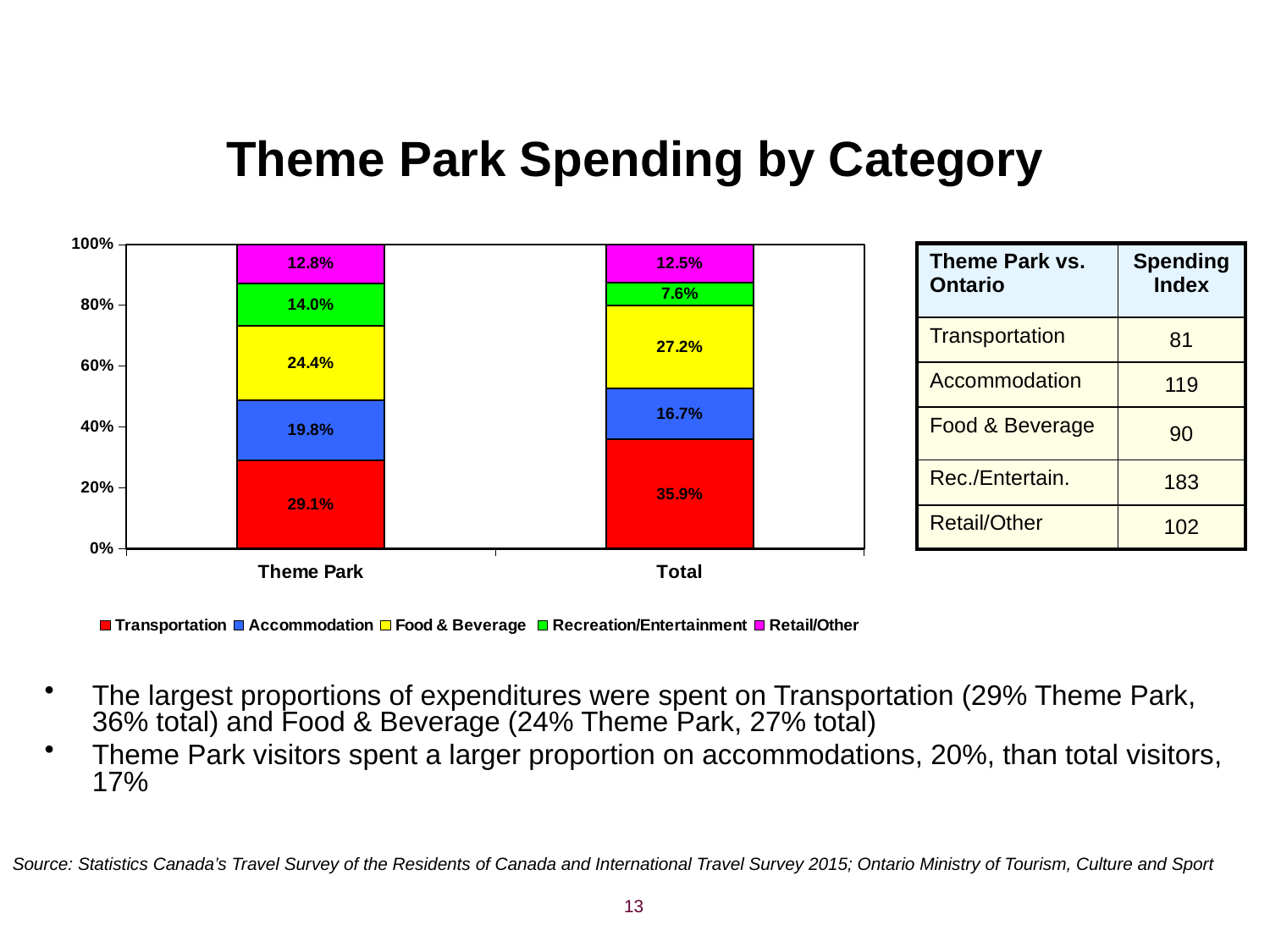
Which is larger: the Accommodation share for Theme Park or for Total? Theme Park Which category has the largest share of Theme Park spending? Transportation What percentage of Total spending went to Food & Beverage? 27.2% What is the difference between the Transportation share for Total and for Theme Park? 6.8% Which category has the smallest share of Total spending? Recreation/Entertainment What is the Accommodation share for the Theme Park bar? 19.8% What colour represents Food & Beverage in the chart? Yellow What percentage of Theme Park spending went to Transportation? 29.1% What is the Recreation/Entertainment share for the Total bar? 7.6% How many series does the legend list? 5 What kind of chart is shown on the slide? Stacked bar chart How many bars are shown in the chart? 2